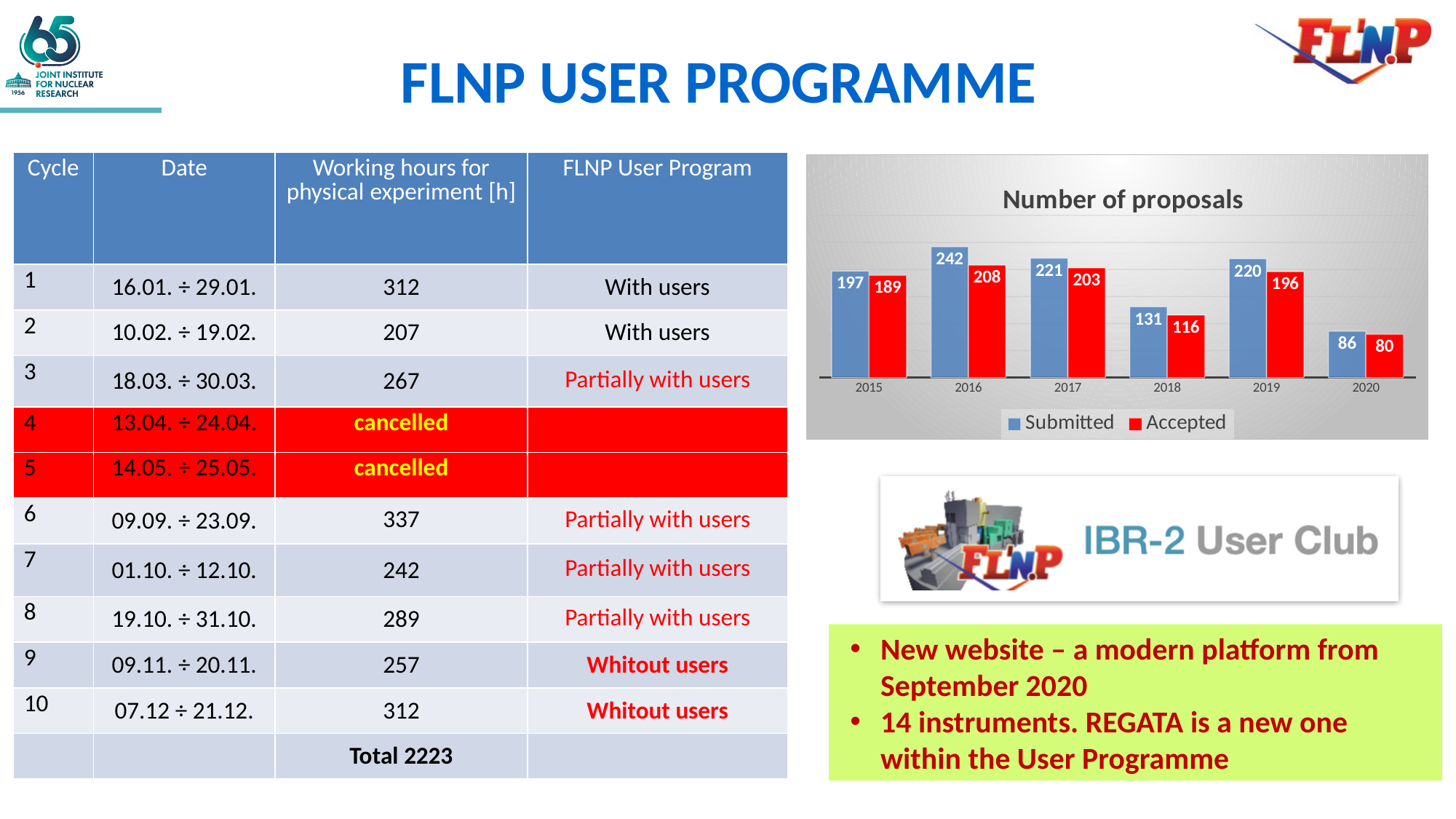
What kind of chart is used to show the number of proposals? Bar chart Which year has the lowest number of accepted proposals? 2020 What is the number of accepted proposals in 2019? 196 Which is larger: the number of accepted proposals in 2017 or in 2019? 2017 What is the title of the chart? Number of proposals What is the number of accepted proposals in 2020? 80 Do the submitted proposals rise or fall from 2019 to 2020? Fall Which year has the highest number of submitted proposals? 2016 What is the difference between submitted and accepted proposals in 2018? 15 What is the number of submitted proposals in 2016? 242 How many series does the chart legend list? 2 How many years are shown on the x axis of the chart? 6